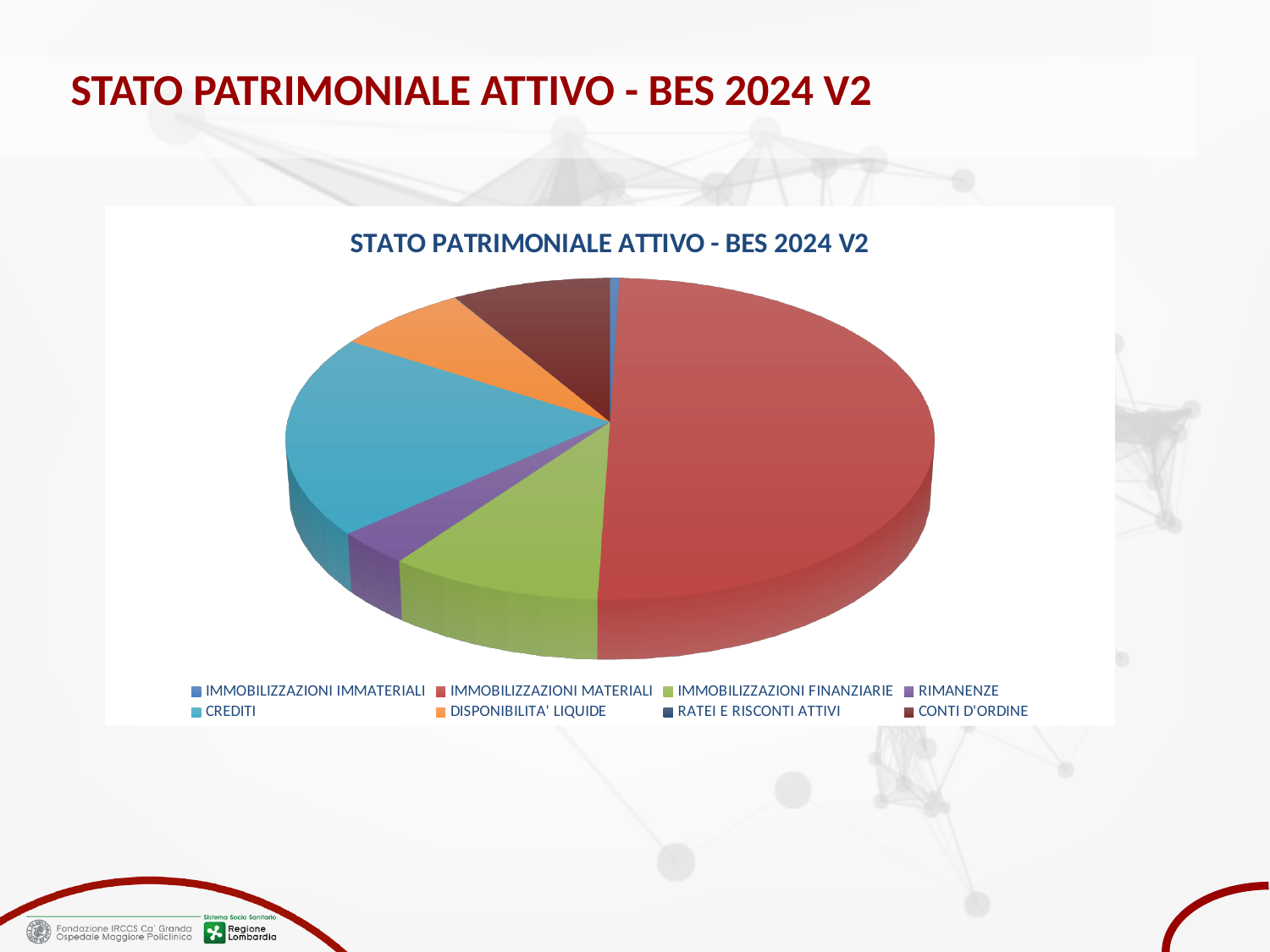
What kind of chart is shown on the slide? Pie chart Which category has the largest slice of the pie? IMMOBILIZZAZIONI MATERIALI Which slice is larger, IMMOBILIZZAZIONI MATERIALI or CREDITI? IMMOBILIZZAZIONI MATERIALI Which slice is larger, IMMOBILIZZAZIONI IMMATERIALI or RIMANENZE? RIMANENZE Which slice is larger, CONTI D'ORDINE or RIMANENZE? CONTI D'ORDINE How many entries does the chart legend list? 8 Which category has the second largest slice of the pie? CREDITI What colour is the IMMOBILIZZAZIONI MATERIALI slice? Red What is the title of the chart? STATO PATRIMONIALE ATTIVO - BES 2024 V2